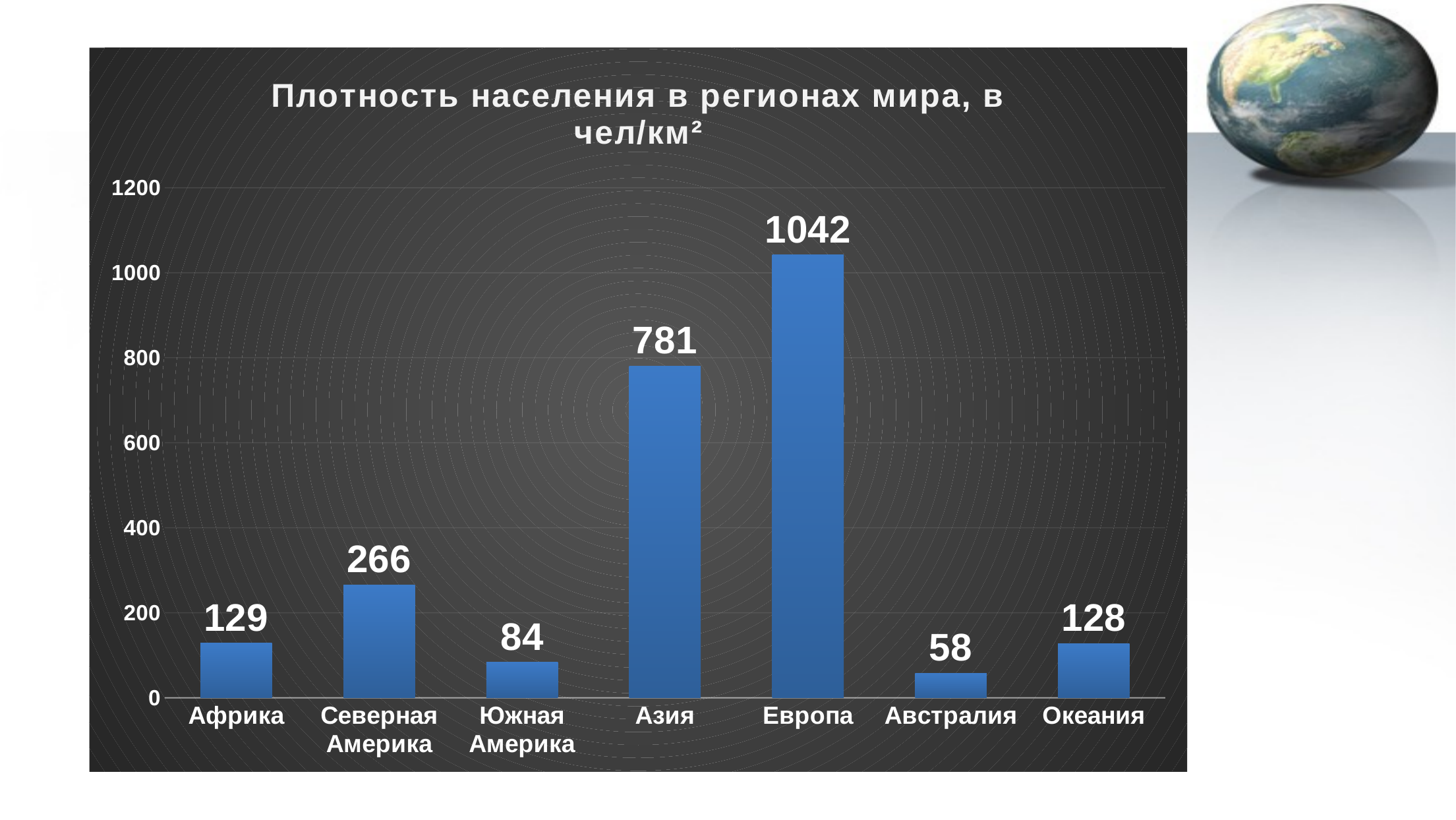
What is the difference between the values for Европа and Азия? 261 What is the title of the chart? Плотность населения в регионах мира, в чел/км² What value is shown for Северная Америка? 266 Is the value for Азия greater or less than 600? greater Which is larger, the value for Африка or the value for Южная Америка? Африка What kind of chart is shown on the slide? bar chart How many regions are shown on the chart? 7 What is the difference between the values for Северная Америка and Южная Америка? 182 Which region has the highest population density on the chart? Европа What is the population density value shown for Азия? 781 Which region has the lowest population density on the chart? Австралия What value is shown for Австралия? 58